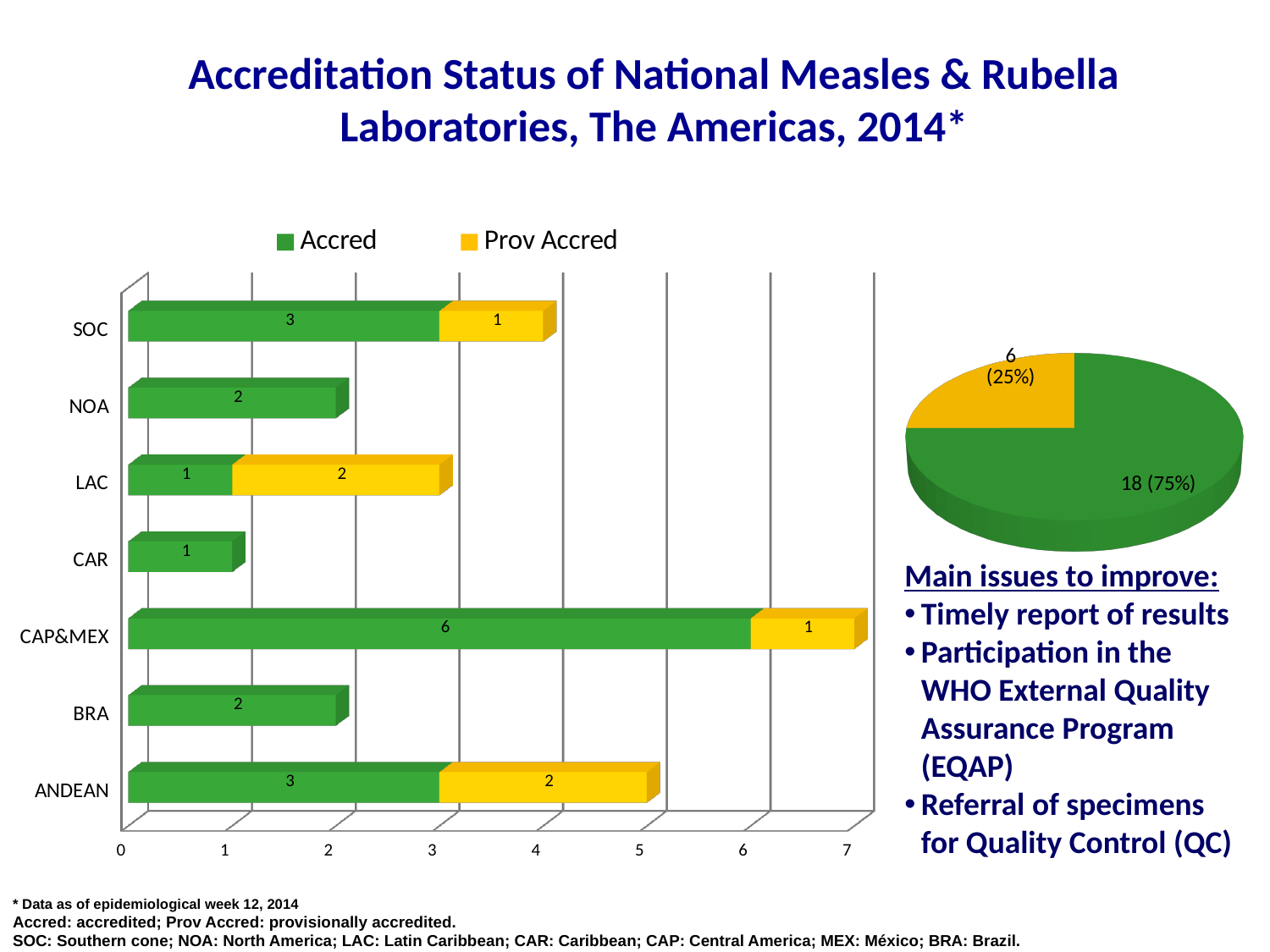
How many series does the legend of the bar chart on the left list? 2 In the pie chart on the right, what is the value of the smaller slice? 6 (25%) In the bar chart on the left, which is larger: the Accred value for NOA or the Accred value for CAR? NOA In the pie chart on the right, what share of the pie does the slice labelled 18 represent? 75% What kind of chart is the chart on the left of the slide? Bar chart In the bar chart on the left, what is the total of the stacked bar for SOC? 4 In the bar chart on the left, what is the Accred value for CAP&MEX? 6 In the bar chart on the left, what is the Prov Accred value for LAC? 2 In the bar chart on the left, what is the total of the stacked bar for ANDEAN? 5 How many categories are shown on the bar chart on the left? 7 In the bar chart on the left, which category has the highest Accred value? CAP&MEX In the bar chart on the left, what is the difference between the Accred values for CAP&MEX and SOC? 3